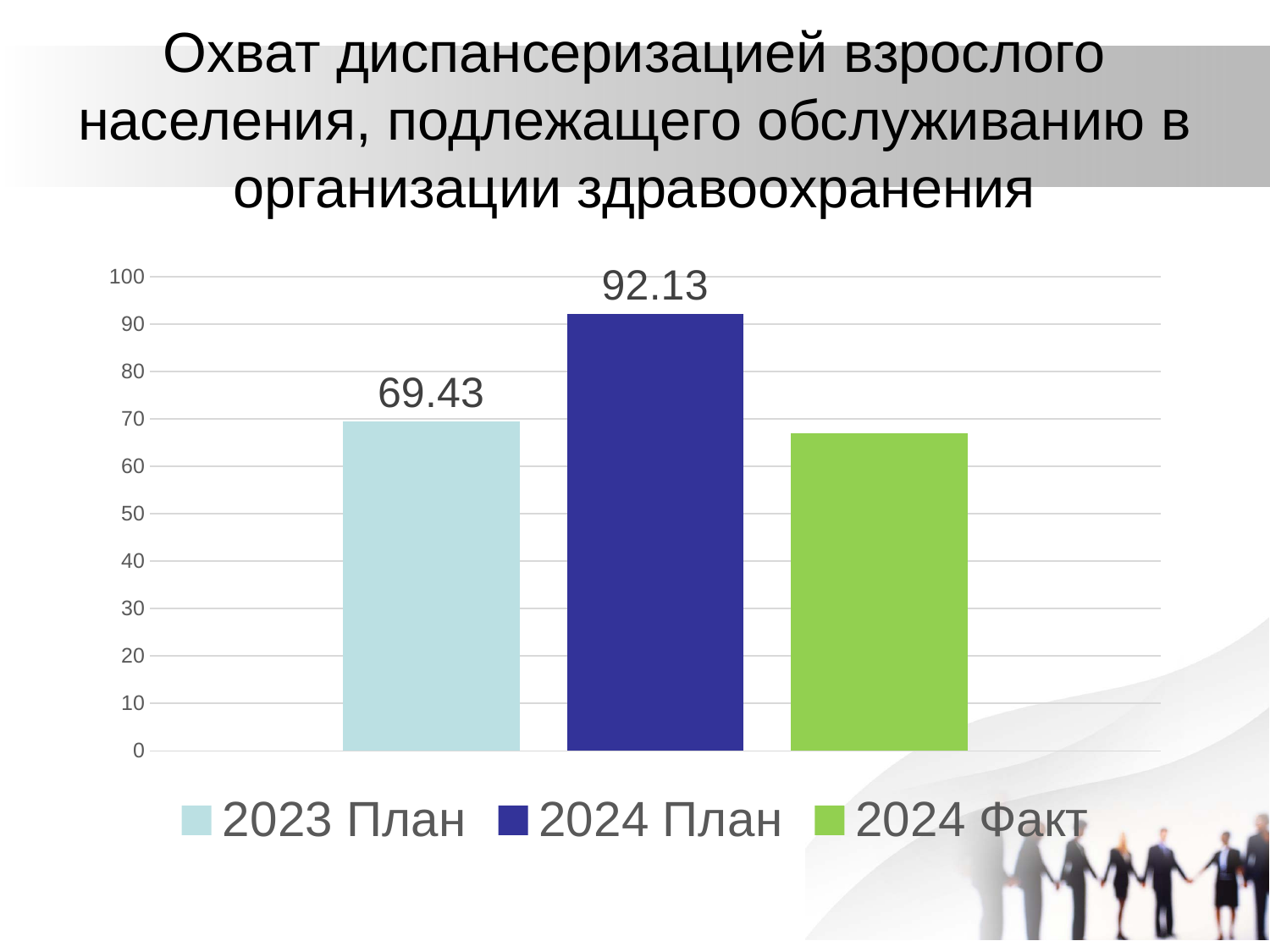
What colour is the bar for 2024 Факт? green Is the value for 2024 План greater or less than 90? greater Which series has the highest value? 2024 План Which is larger, the value for 2024 План or the value for 2023 План? 2024 План What is the value for 2023 План? 69.43 How many bars are plotted in the chart? 3 What is the value for 2024 План? 92.13 Is the value for 2024 Факт greater or less than 70? less How many series does the legend list? 3 Is the value for 2024 Факт greater or less than 60? greater What kind of chart is shown on the slide? bar chart What is the difference between the 2024 План and 2023 План values? 22.70